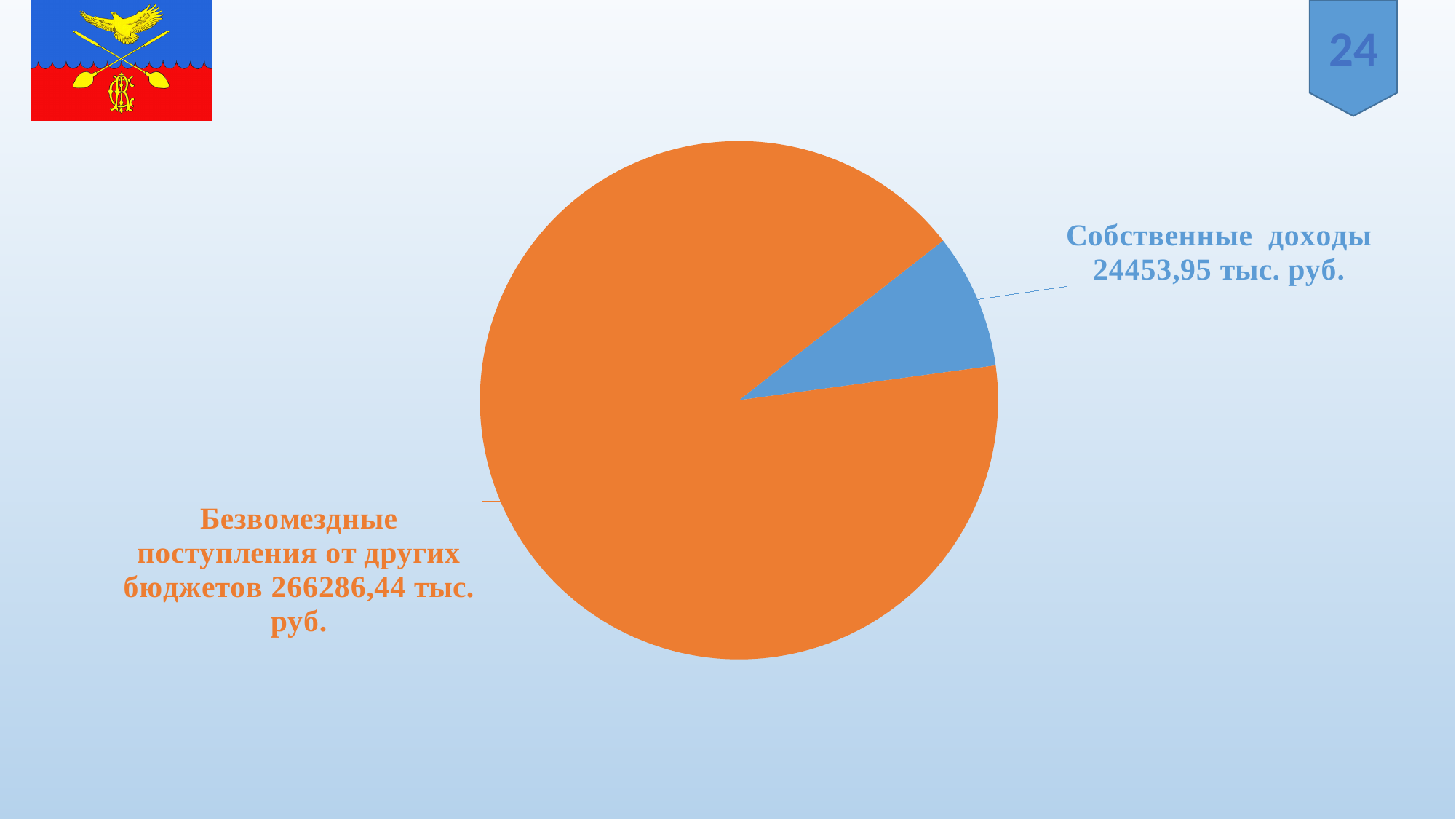
What is the difference between Безвомездные поступления от других бюджетов and Собственные доходы? 241832,49 тыс. руб. What colour is the slice for Собственные доходы? Blue What is the value shown for Собственные доходы? 24453,95 тыс. руб. What kind of chart is shown on the slide? Pie chart Which is larger: Собственные доходы or Безвомездные поступления от других бюджетов? Безвомездные поступления от других бюджетов Which category has the smallest slice of the pie? Собственные доходы What is the total of the two values shown in the pie chart? 290740,39 тыс. руб. How many slices does the pie chart have? 2 What is the value shown for Безвомездные поступления от других бюджетов? 266286,44 тыс. руб. Which category has the largest slice of the pie? Безвомездные поступления от других бюджетов